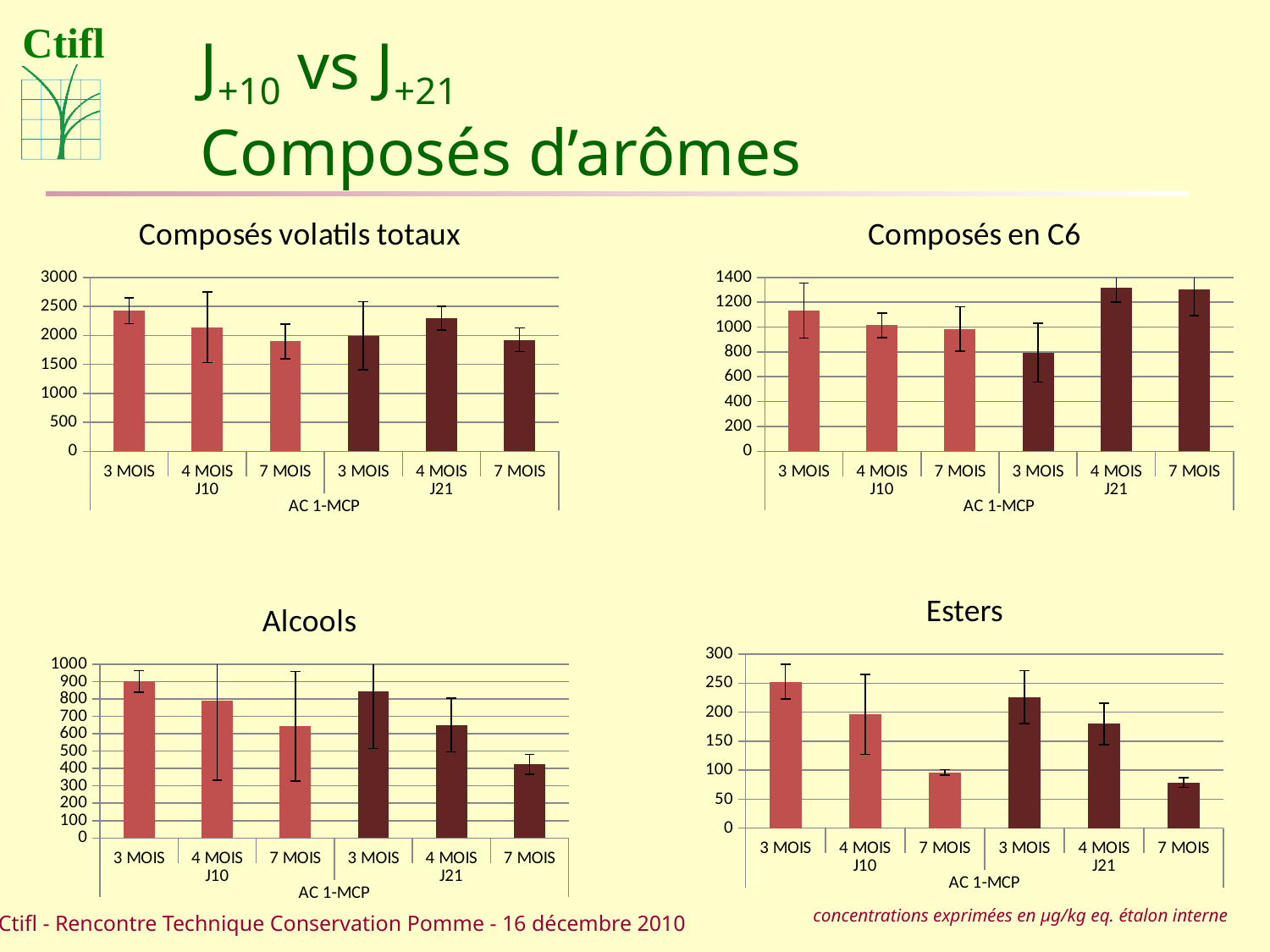
What kind of chart is the 'Alcools' chart? bar chart What is the title of the top-left chart? Composés volatils totaux In the 'Composés en C6' chart, is the value for 4 MOIS under J21 greater or less than 1200? greater In the 'Alcools' chart, which bar is the lowest? 7 MOIS (J21) In the 'Composés en C6' chart, which bar is the lowest? 3 MOIS (J21) In the 'Composés en C6' chart, how many bars are plotted? 6 In the 'Composés en C6' chart, is the value for 3 MOIS under J21 greater or less than 1000? less In the 'Alcools' chart, which is larger: 4 MOIS under J10 or 4 MOIS under J21? 4 MOIS under J10 In the 'Alcools' chart, is the value for 7 MOIS under J21 greater or less than 500? less In the 'Esters' chart, do the values rise or fall from 3 MOIS to 7 MOIS within the J10 group? fall In the 'Composés en C6' chart, which is larger: 3 MOIS under J10 or 3 MOIS under J21? 3 MOIS under J10